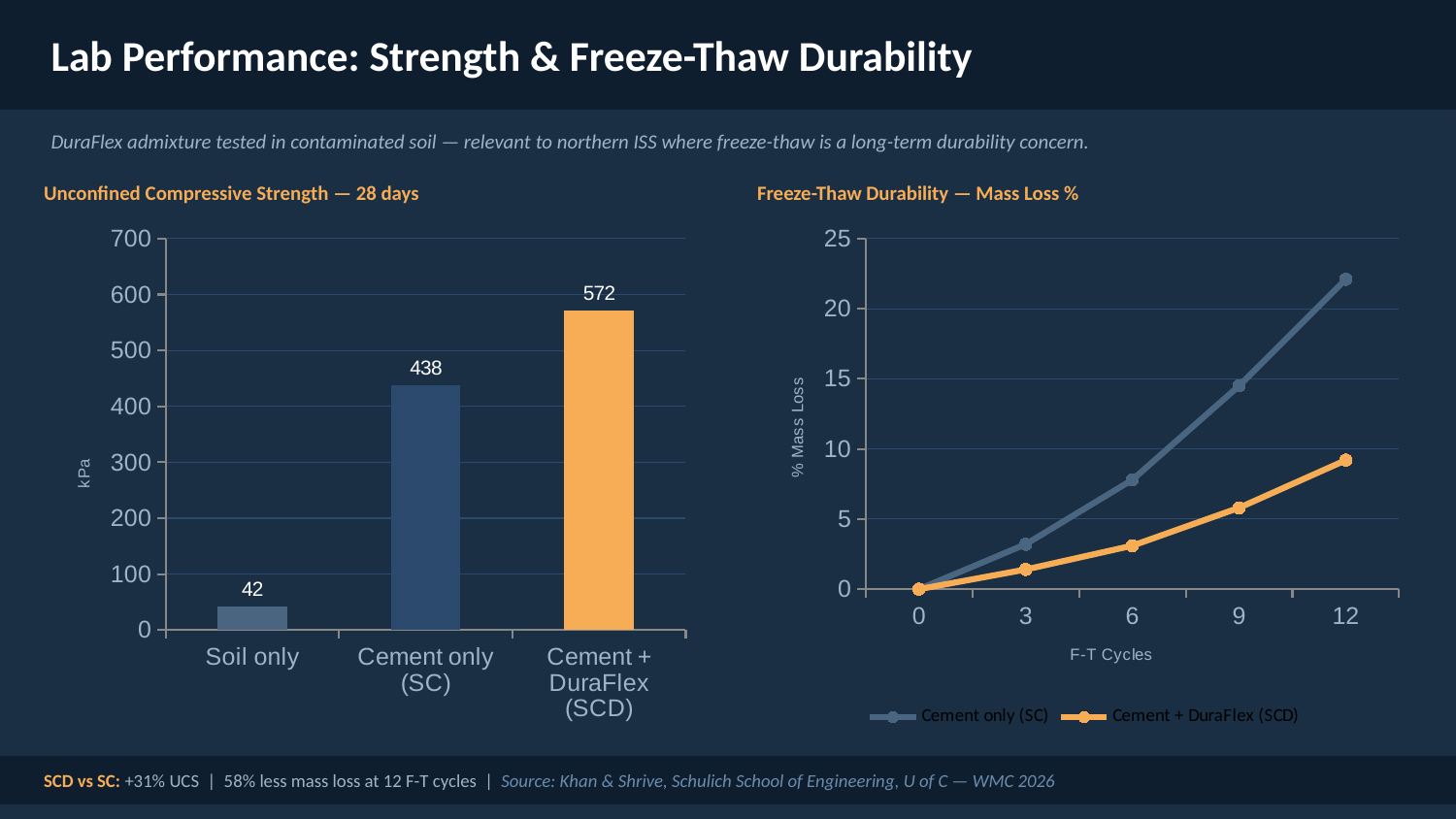
In the Unconfined Compressive Strength chart, which category has the highest value? Cement + DuraFlex (SCD) In the Unconfined Compressive Strength chart, which category has the lowest value? Soil only In the Unconfined Compressive Strength chart, what is the difference between Cement + DuraFlex (SCD) and Cement only (SC)? 134 In the Unconfined Compressive Strength chart, what is the value for Cement + DuraFlex (SCD)? 572 In the Unconfined Compressive Strength chart, what is the value for Cement only (SC)? 438 What kind of chart is the Unconfined Compressive Strength chart? Bar chart In the Freeze-Thaw Durability chart, does the mass loss for Cement only (SC) rise or fall as F-T cycles increase? Rise In the Freeze-Thaw Durability chart, is the value for Cement + DuraFlex (SCD) at 12 F-T cycles greater or less than 10? less In the Freeze-Thaw Durability chart, how many series does the legend list? 2 In the Unconfined Compressive Strength chart, how many categories are shown? 3 In the Freeze-Thaw Durability chart, is the value for Cement only (SC) at 12 F-T cycles greater or less than 20? greater In the Unconfined Compressive Strength chart, what is the value for Soil only? 42